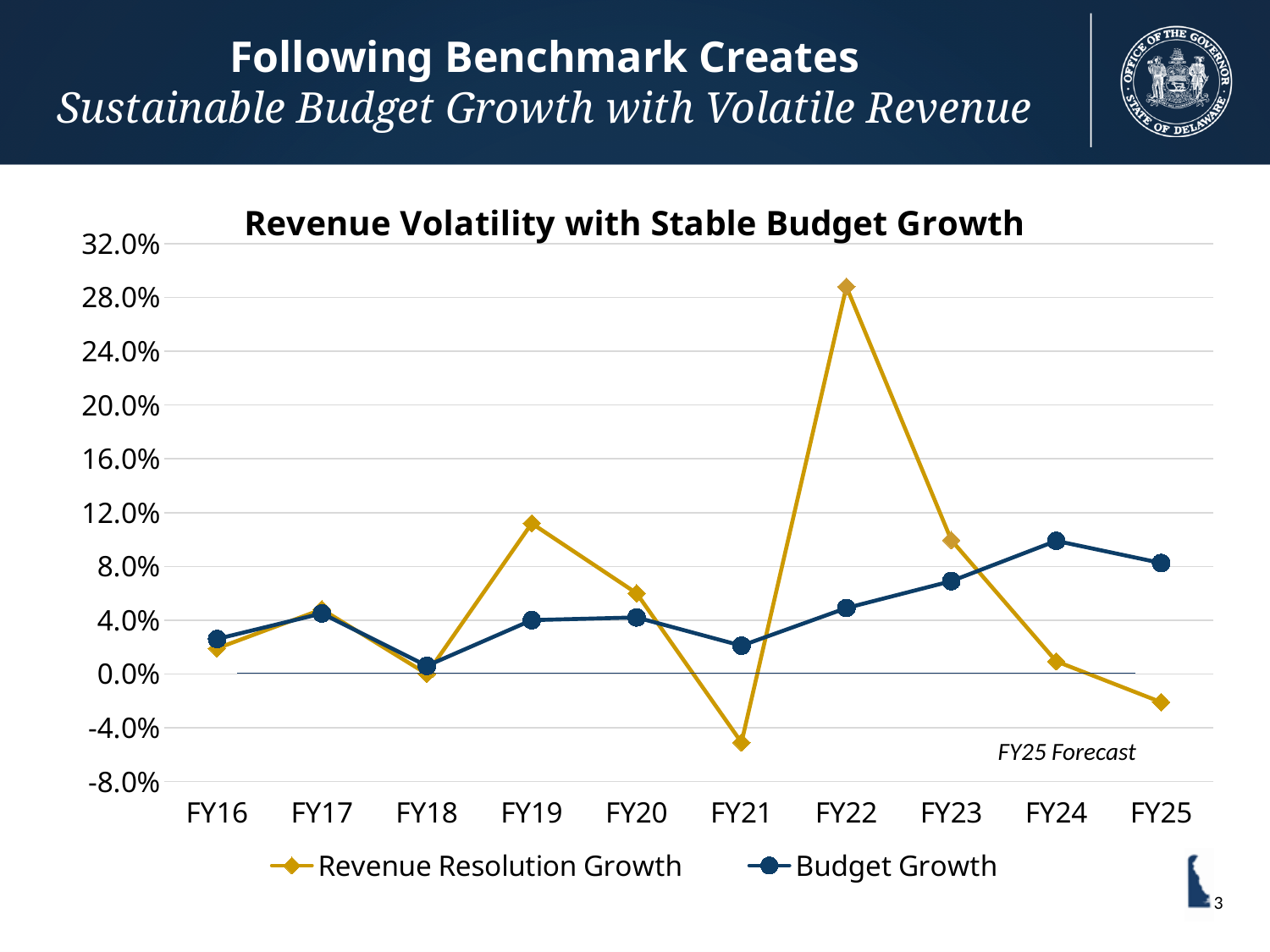
How many fiscal years are plotted along the x axis? 10 In which fiscal year is Budget Growth highest? FY24 In FY24, which series has the larger value, Revenue Resolution Growth or Budget Growth? Budget Growth Is the value for Revenue Resolution Growth in FY21 greater or less than 0.0%? less What kind of chart is shown on the slide? Line chart In which fiscal year is Budget Growth lowest? FY18 In which fiscal year is Revenue Resolution Growth lowest? FY21 Does Budget Growth rise or fall from FY21 to FY24? Rise How many series does the legend list? 2 Is the value for Revenue Resolution Growth in FY22 greater or less than 24.0%? greater Is the value for Budget Growth in FY24 greater or less than 8.0%? greater In which fiscal year is Revenue Resolution Growth highest? FY22